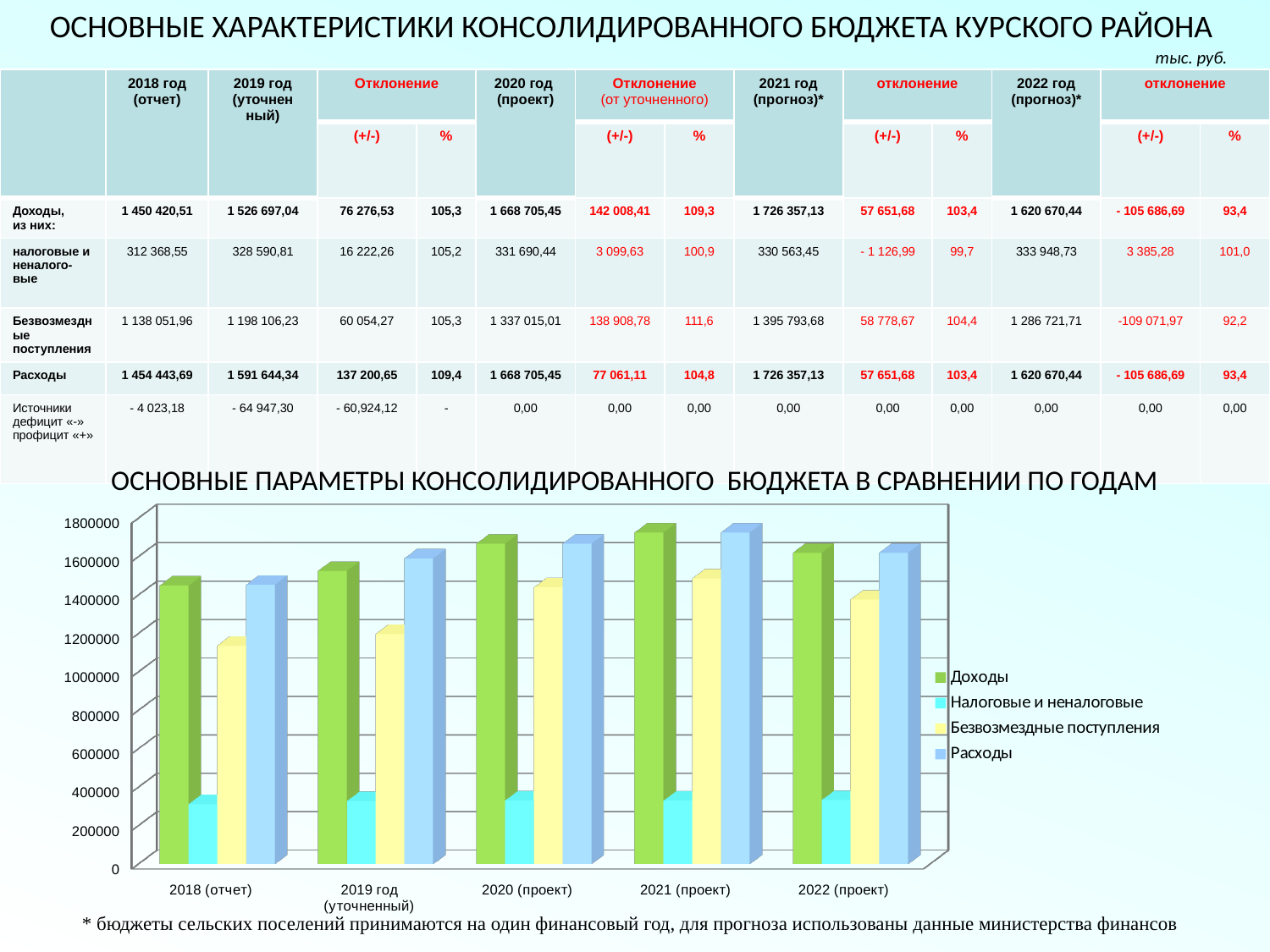
In which year is the Безвозмездные поступления bar the lowest? 2018 (отчет) In which year is the Доходы bar the lowest? 2018 (отчет) Is the value of Безвозмездные поступления for 2020 (проект) greater or less than 1400000? greater How many year categories are shown on the x axis of the chart? 5 How many series does the chart legend list? 4 What kind of chart is shown on the slide? bar chart How do the Доходы values change from 2018 (отчет) to 2021 (проект)? they rise Which colour represents the Расходы series in the chart? light blue For 2019 год (уточненный), which is larger: Доходы or Расходы? Расходы Is the value of Расходы for 2021 (проект) greater or less than 1600000? greater Is the value of Налоговые и неналоговые for 2018 (отчет) greater or less than 400000? less In which year is the Доходы bar the highest? 2021 (проект)